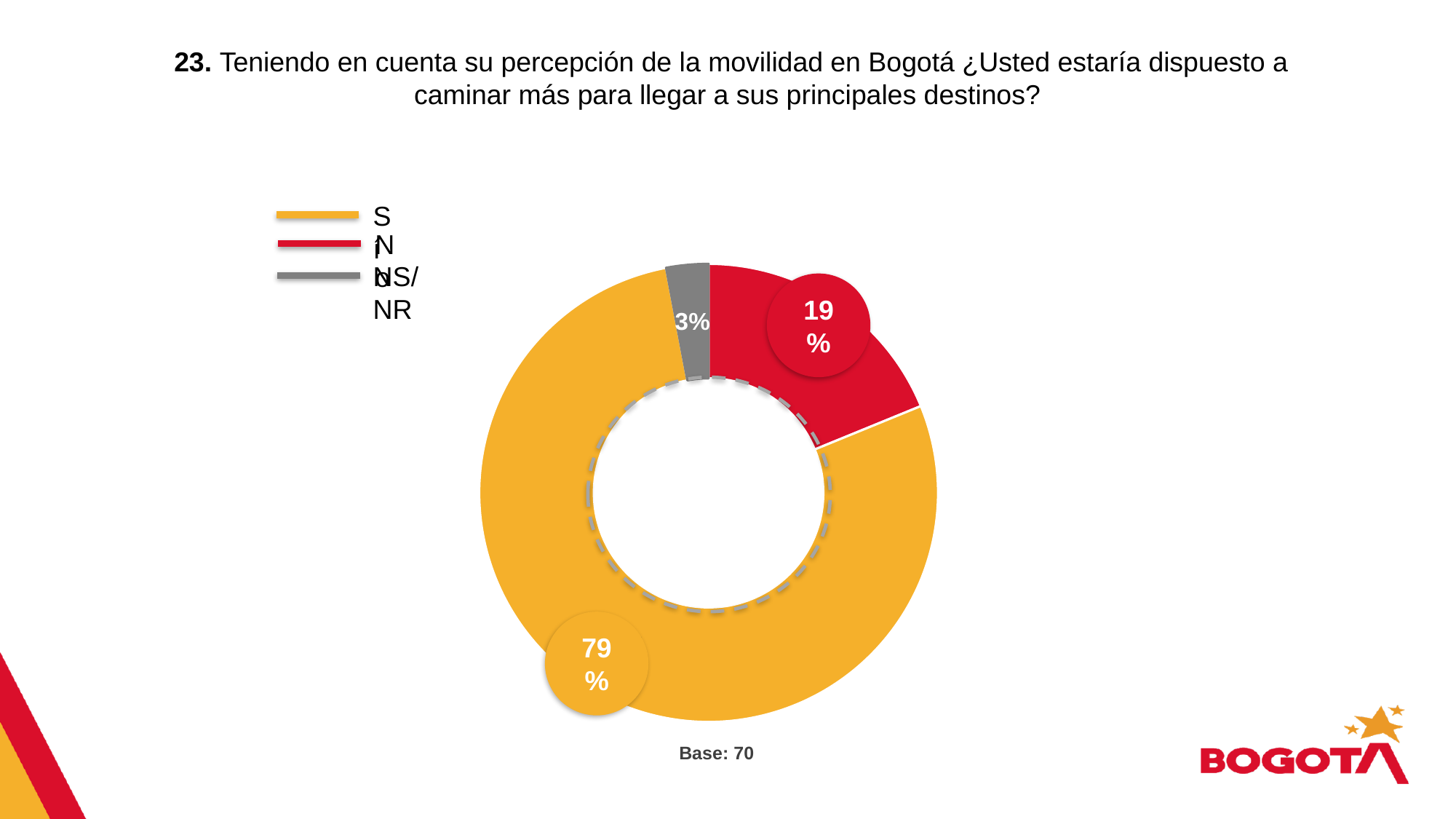
What is the base (number of respondents) stated below the chart? 70 What percentage of respondents answered "Sí" (the yellow slice)? 79% How many slices does the chart have? 3 Which response has the smallest share of the chart? NS/NR What percentage of respondents answered "No" (the red slice)? 19% What is the difference in percentage points between the "Sí" and "No" slices? 60 Which is larger, the "No" slice or the NS/NR slice? No How many entries does the legend list? 3 What percentage is shown for the NS/NR (grey) slice? 3% What colour is used for the NS/NR slice? grey What kind of chart is shown on the slide? doughnut (pie) chart Which response has the largest share of the chart? Sí